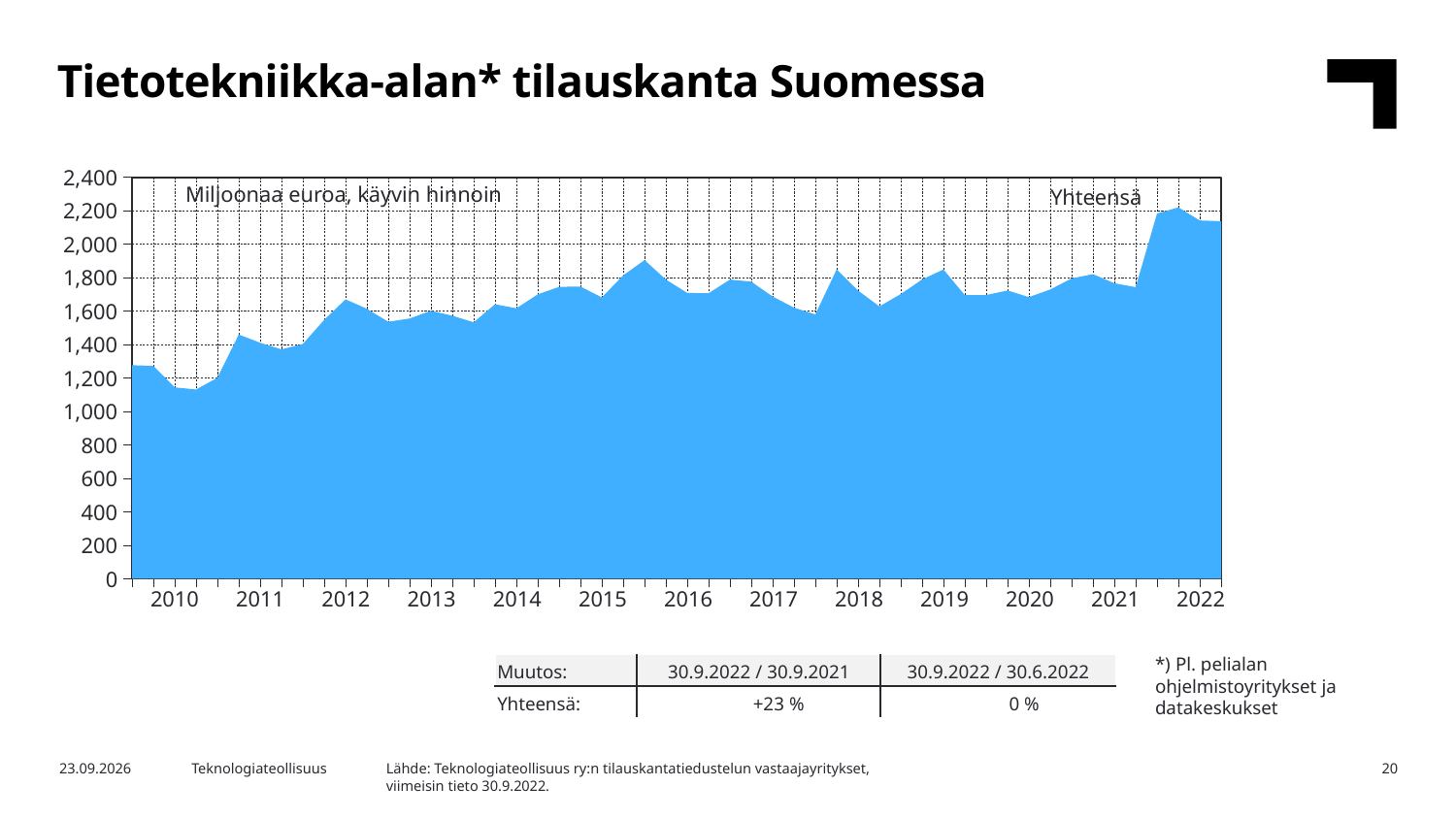
In which year does the chart reach its highest value? 2022 Is the value at the end of 2022 greater or less than 2,000? greater Overall, do the values rise or fall from 2010 to 2022? rise In which year does the chart reach its lowest value? 2010 What kind of chart is shown on the slide? Area chart What is the name of the series plotted in the chart? Yhteensä Is the value at the start of 2010 greater or less than 1,400? less In what unit are the values on the chart expressed, according to the label inside the plot area? Miljoonaa euroa, käyvin hinnoin What is the title of the slide's chart? Tietotekniikka-alan* tilauskanta Suomessa According to the table below the chart, what is the change in Yhteensä for 30.9.2022 / 30.9.2021? +23 % How many years are labelled on the x axis of the chart? 13 How many series does the chart show? 1